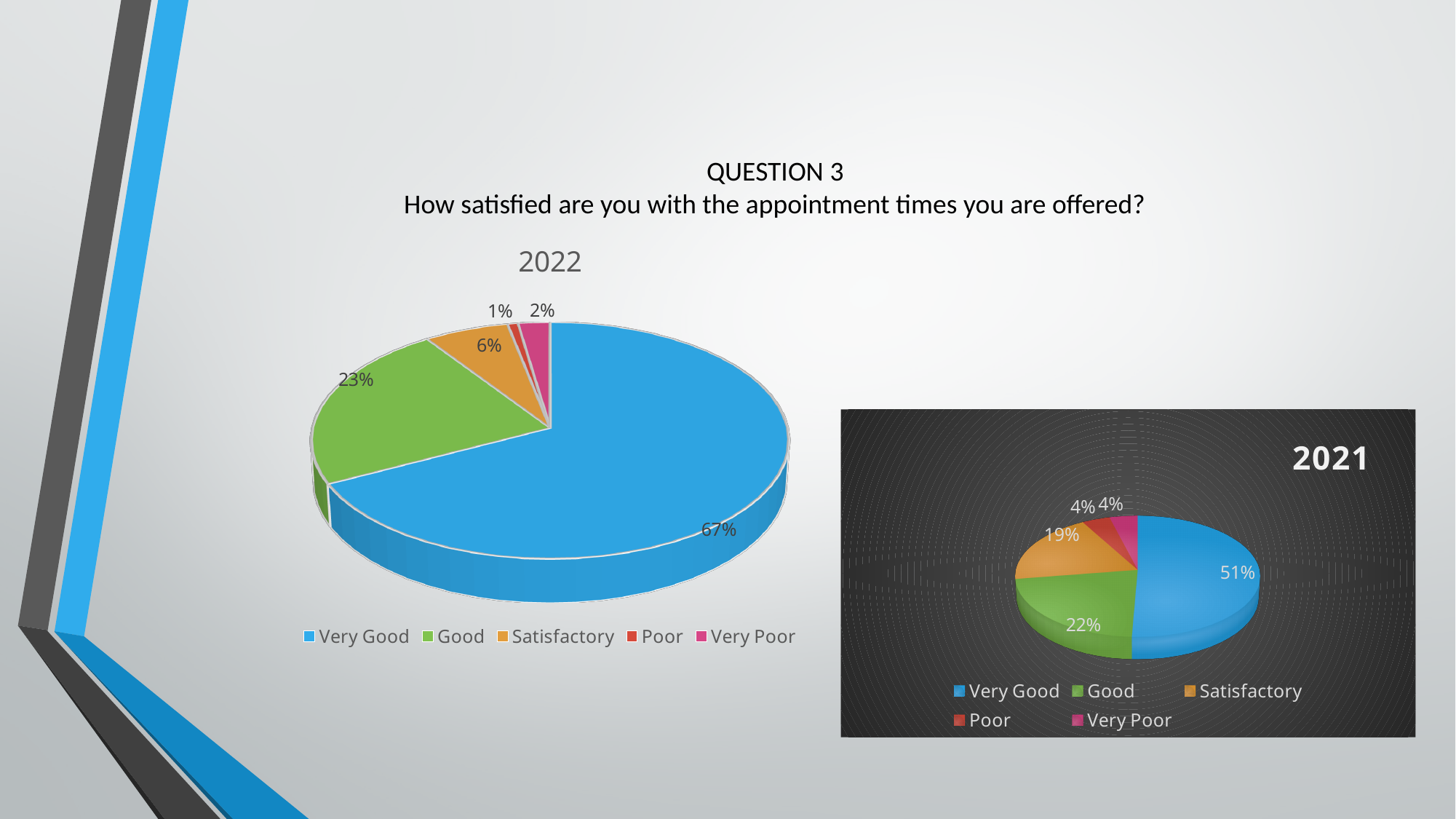
In the 2022 chart, what percentage of respondents answered Satisfactory? 6% In the 2021 chart, what percentage of respondents answered Satisfactory? 19% What is the difference between the Very Good share in 2022 and the Very Good share in 2021? 16% In the 2022 chart, which category has the smallest share? Poor Which is larger in the 2021 chart: the Good share or the Satisfactory share? Good In the 2022 chart, what percentage of respondents answered Good? 23% How many categories does the legend of the 2021 chart list? 5 In the 2021 chart, which category has the largest share? Very Good In the 2021 chart, what percentage of respondents answered Very Good? 51% What kind of chart is the 2022 chart? Pie chart In the 2022 chart, which category has the largest share? Very Good In the 2022 chart, what percentage of respondents answered Very Good? 67%